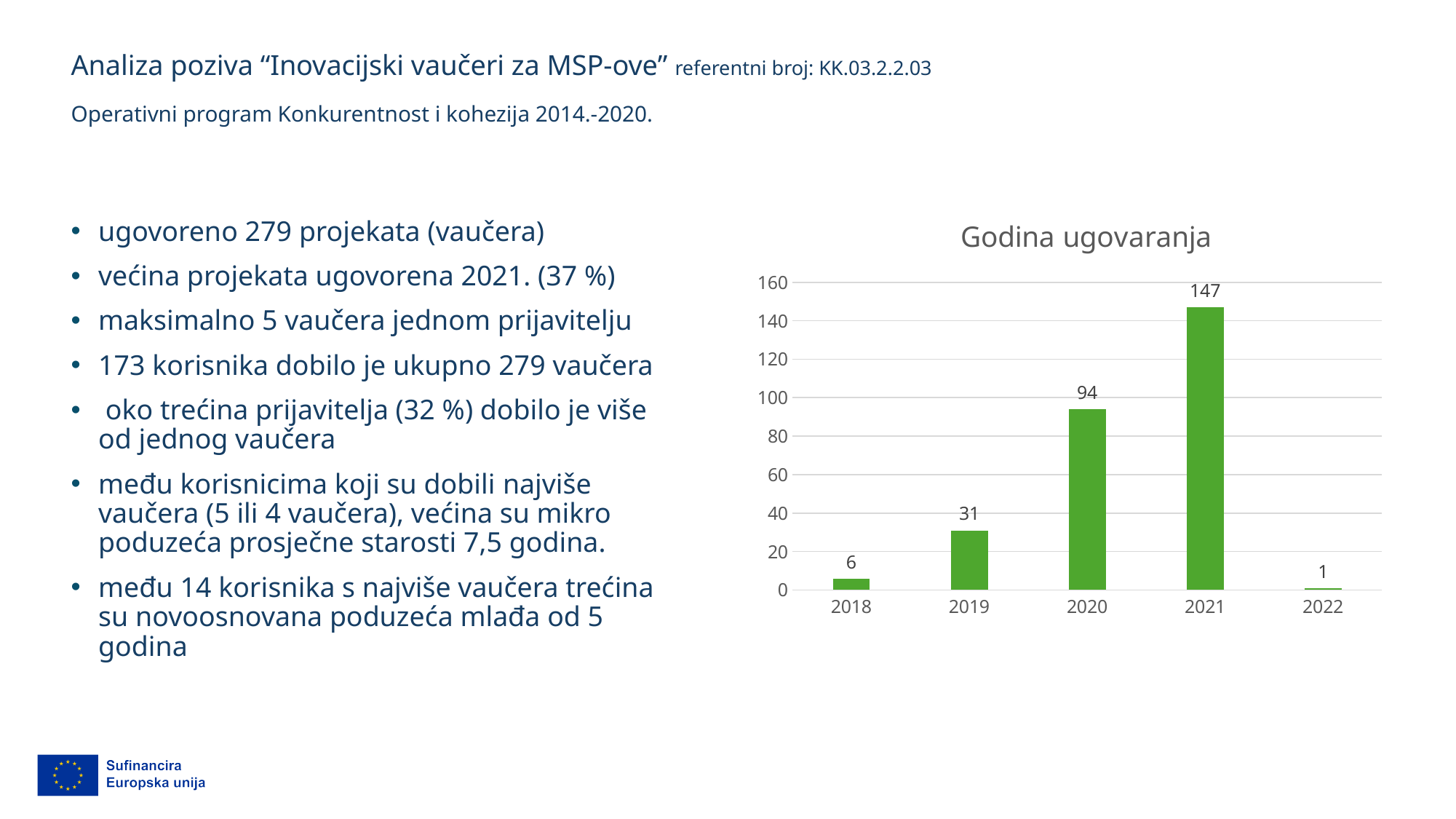
What is the difference between the values for 2021 and 2020? 53 What kind of chart is shown on the slide? bar chart Which year has the lowest value in the chart? 2022 What is the value for 2019 in the chart? 31 What is the title of the chart? Godina ugovaranja How many years are shown on the x axis of the chart? 5 Which year has the highest value in the chart? 2021 What is the value for 2021 in the chart? 147 What is the value for 2018 in the chart? 6 Is the value for 2020 greater or less than 80? greater Which is larger, the value for 2019 or the value for 2020? 2020 Do the values rise or fall from 2018 to 2021? rise